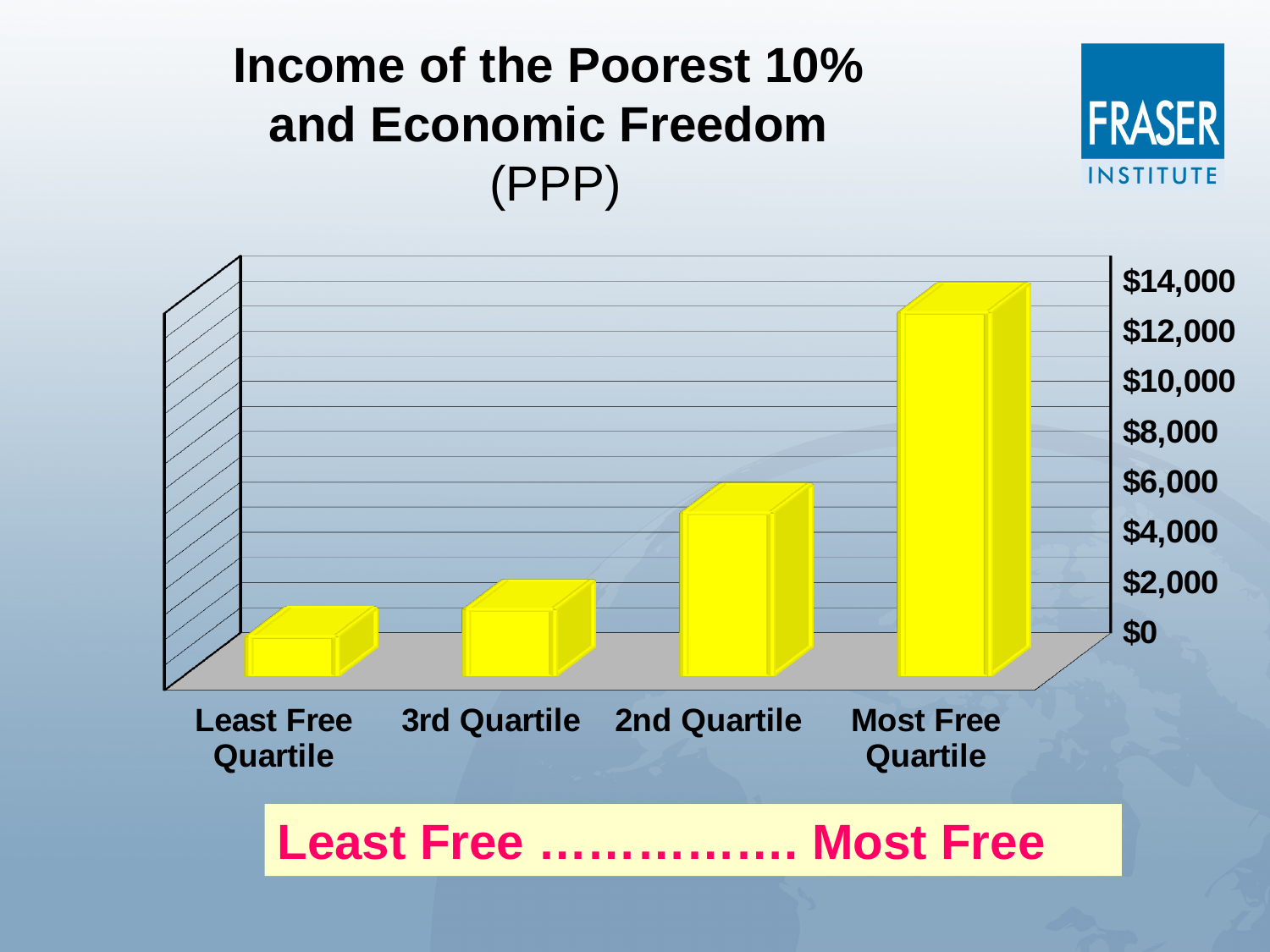
Is the value for the 3rd Quartile greater or less than $6,000? less How many categories are shown on the x axis of the chart? 4 Is the value for the Most Free Quartile greater or less than $10,000? greater Which category has the highest bar in the chart? Most Free Quartile What kind of chart is shown on the slide? Bar chart Which category has the lowest bar in the chart? Least Free Quartile Which is larger, the value for the Most Free Quartile or the 2nd Quartile? Most Free Quartile Which is larger, the value for the 2nd Quartile or the 3rd Quartile? 2nd Quartile Is the value for the 2nd Quartile greater or less than $4,000? greater What is the title of the chart on the slide? Income of the Poorest 10% and Economic Freedom (PPP) Do the values rise or fall moving from the Least Free Quartile to the Most Free Quartile along the x axis? Rise